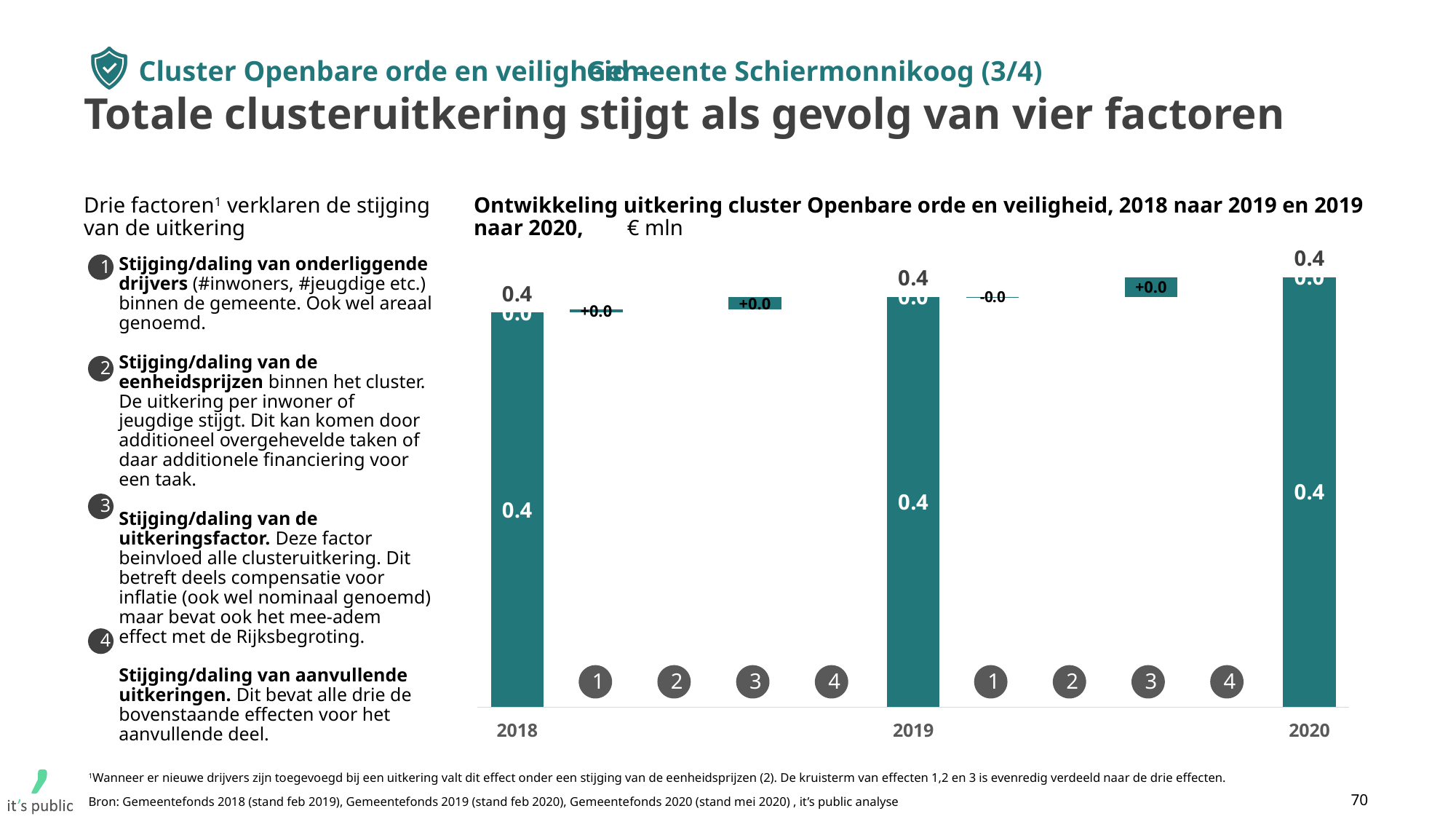
What is the total uitkering for 2020 shown on the chart? 0.4 How many numbered factors are shown between each pair of year totals? 4 What is the difference between the total for 2020 and the total for 2018? 0.0 How many years are shown as total bars on the chart? 3 What is the total uitkering for 2018 shown on the chart? 0.4 In what unit are the values on the chart expressed? € mln Does the total uitkering rise, fall or stay the same from 2018 to 2020? rises What kind of chart is shown on the slide? bar chart What is the labelled effect of factor 1 between 2018 and 2019? +0.0 Which cluster does the chart title refer to? Openbare orde en veiligheid What is the labelled effect of factor 1 between 2019 and 2020? -0.0 What is the total uitkering for 2019 shown on the chart? 0.4